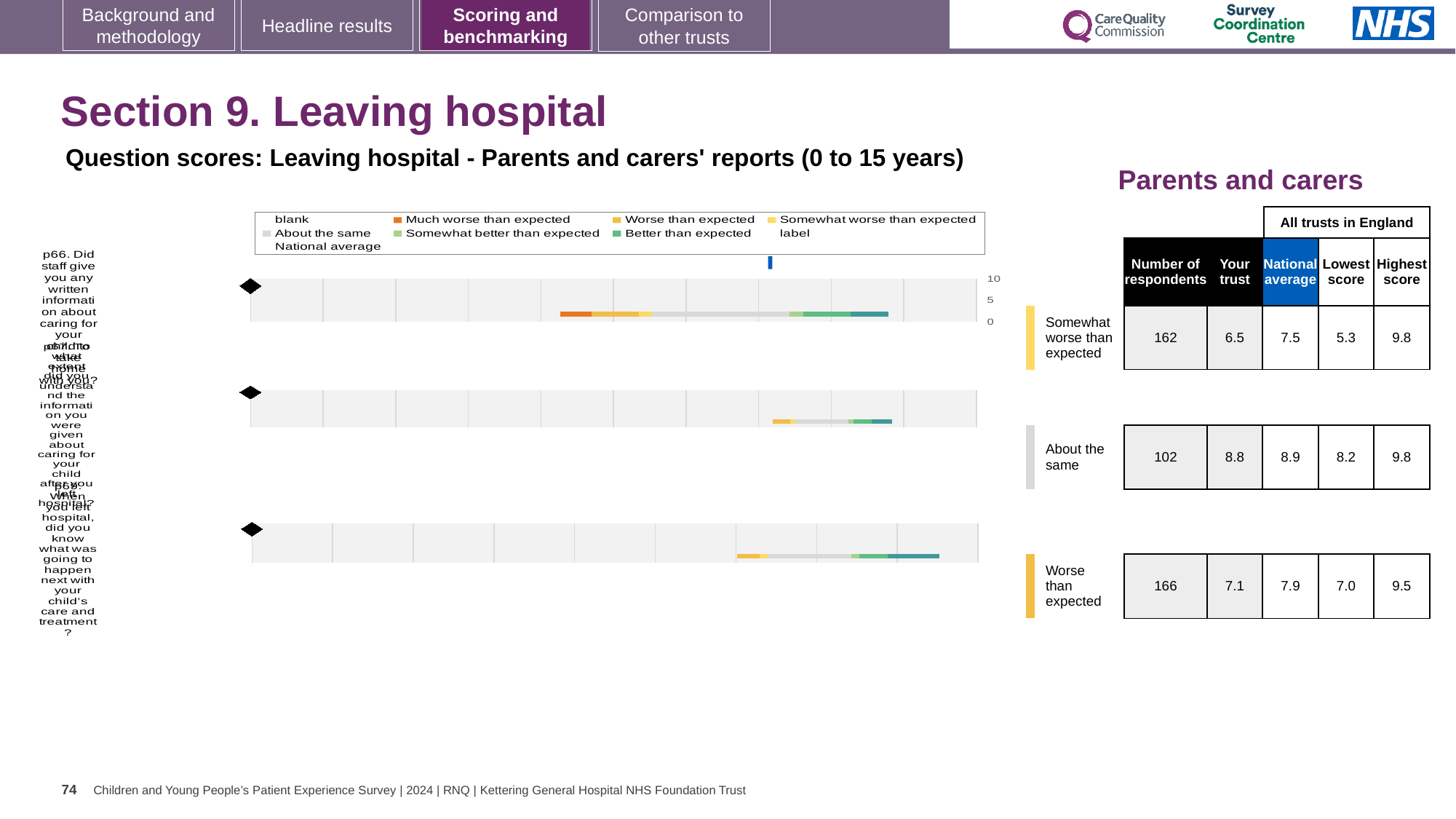
Which rating row has the highest number of respondents? Worse than expected What is the national average for the question rated 'About the same'? 8.9 What is the 'Your trust' score for the question rated 'Somewhat worse than expected'? 6.5 How many respondents answered the question rated 'Worse than expected'? 166 How many question bars are plotted on the slide? 3 For the question rated 'Worse than expected', what is the difference between the national average and the 'Your trust' score? 0.8 What is the highest score across all trusts in England for the question rated 'Worse than expected'? 9.5 Which rating row has the lowest 'Lowest score' value? Somewhat worse than expected What kind of chart is used to show the question scores on this slide? bar chart What is the title shown above the charts? Question scores: Leaving hospital - Parents and carers' reports (0 to 15 years) What colour does the legend use for 'Much worse than expected'? Orange For the question rated 'About the same', which is larger: the 'Your trust' score or the national average? National average